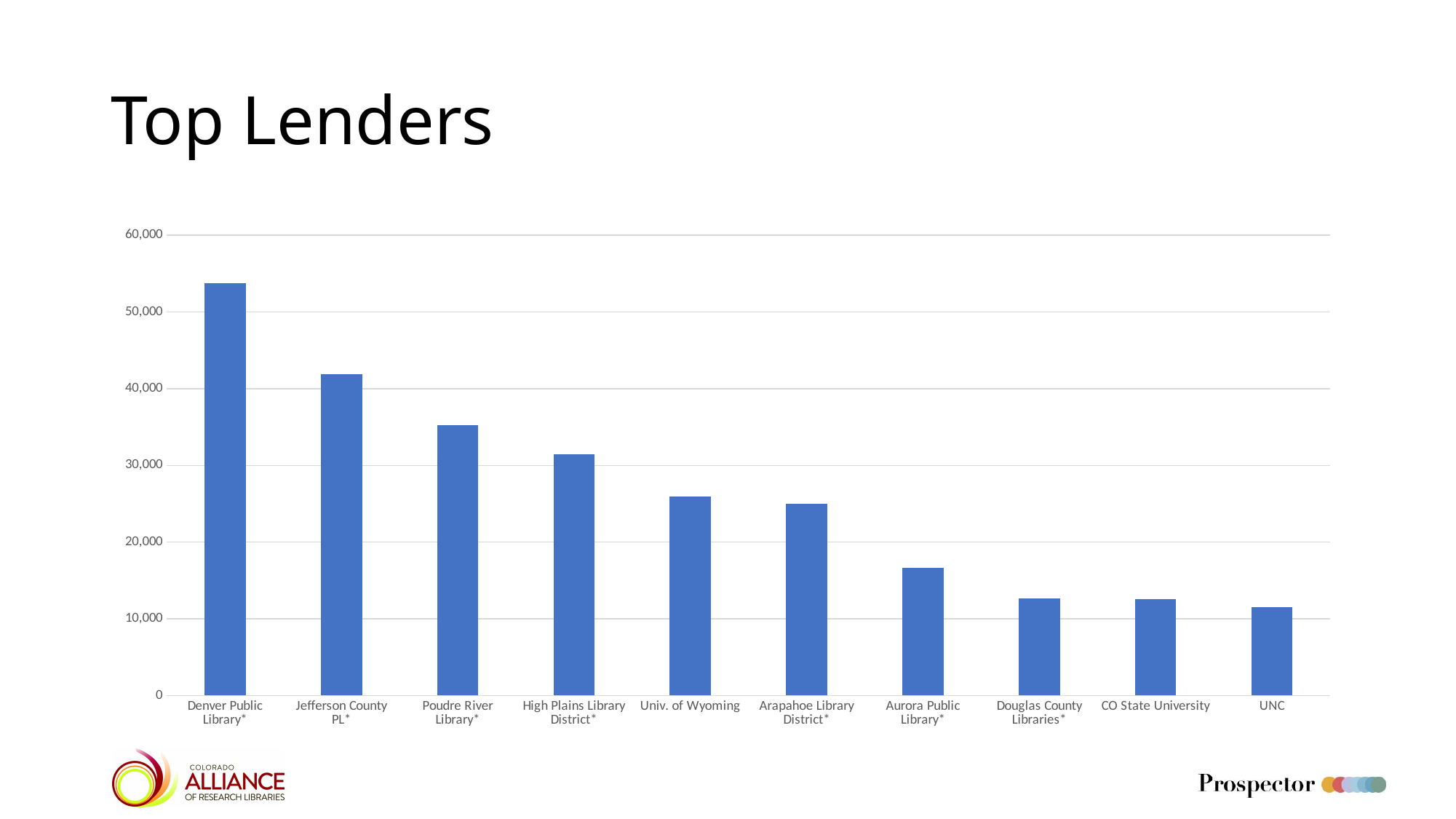
Which lender has the lowest value in the chart? UNC Which lender has the highest value in the chart? Denver Public Library* Is the value for Poudre River Library* greater or less than 40,000? less Is the value for High Plains Library District* greater or less than 30,000? greater What type of chart is shown on the slide? bar chart Is the value for Denver Public Library* greater or less than 50,000? greater Do the values rise or fall moving from left to right along the x axis? fall What is the title of the slide containing the chart? Top Lenders How many lenders are shown in the chart? 10 Which is larger, the value for Univ. of Wyoming or the value for Aurora Public Library*? Univ. of Wyoming